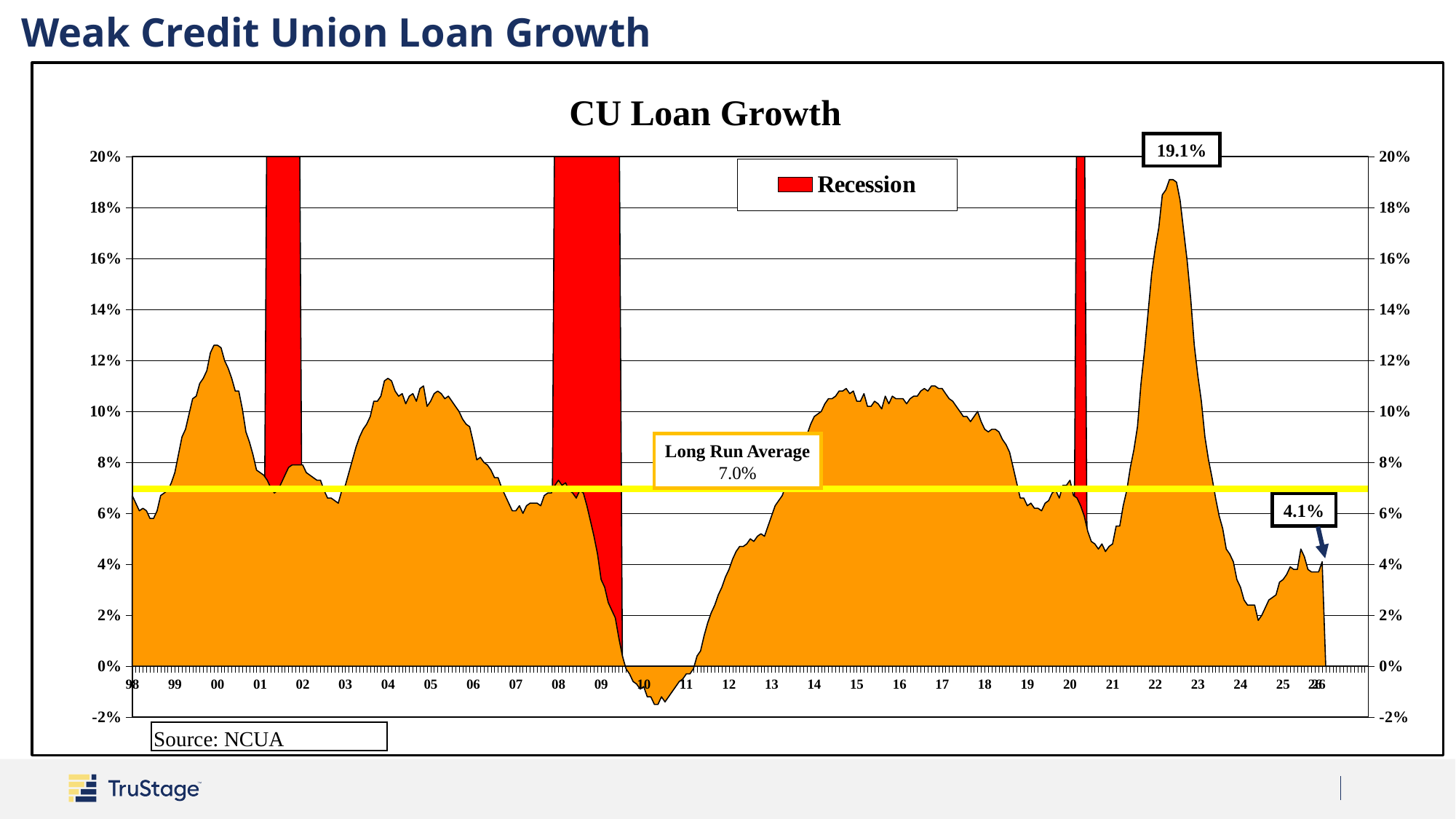
Is the value for CU loan growth around 2016 greater or less than 8%? greater What is the long run average of CU loan growth shown on the chart? 7.0% What is the difference between the labeled peak value of 19.1% and the latest value of 4.1%? 15.0 percentage points What does the red shading in the legend represent? Recession Does CU loan growth rise or fall from its 2022 peak to 2024? fall What is the peak value of CU loan growth labeled on the chart? 19.1% Is the lowest value of CU loan growth around 2010 greater or less than 0%? less What is the title of the chart? CU Loan Growth How many recession periods are shaded on the chart? 3 Is the latest value of 4.1% larger or smaller than the long run average of 7.0%? smaller What is the most recent CU loan growth value labeled on the chart? 4.1% What kind of chart is shown on the slide? area chart